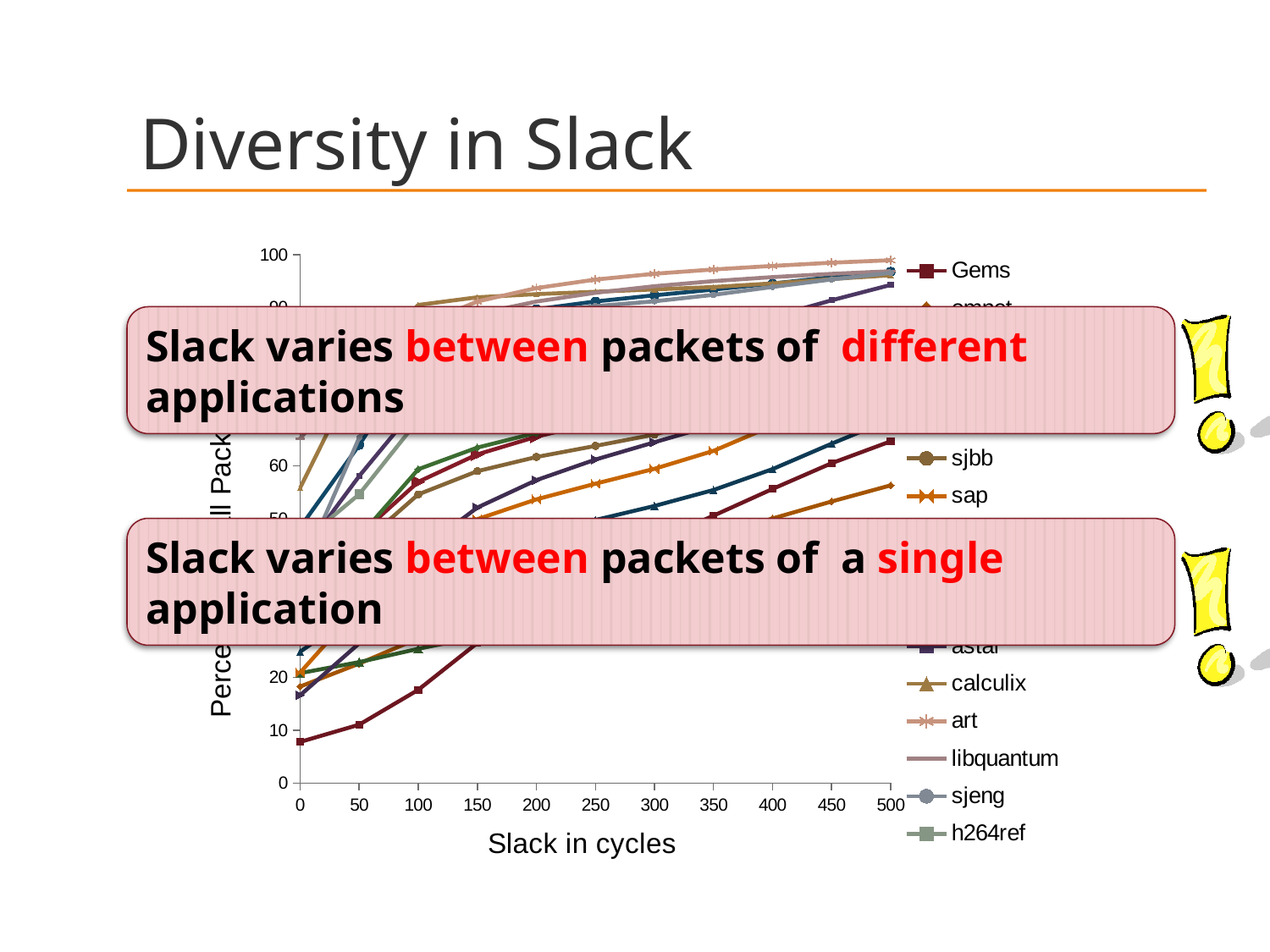
Is the value for Gems at a slack of 0 cycles greater or less than 10? less Is the value for art at a slack of 500 cycles greater or less than 90? greater What kind of chart is shown on the slide? line chart As slack in cycles increases, does the Gems line rise or fall? rise Is the value for Gems at a slack of 500 cycles greater or less than 60? greater How many tick values are labelled along the x axis of the chart? 11 What is the highest value shown on the x axis of the chart? 500 At a slack of 500 cycles, which series has the larger value, art or sap? art At a slack of 0 cycles, which series has the larger value, sap or Gems? sap What is the label of the x axis of the chart? Slack in cycles